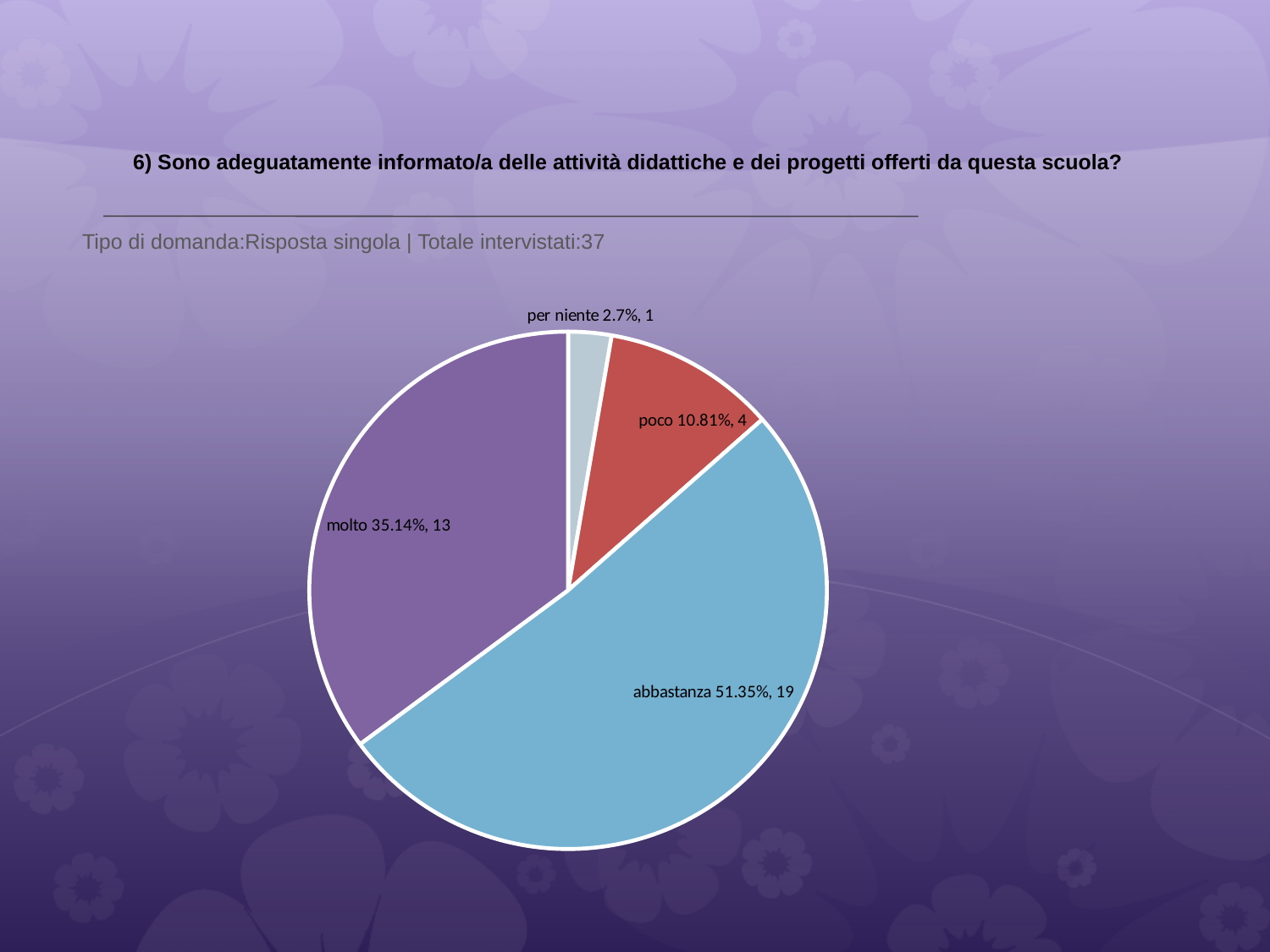
What percentage is shown for the 'abbastanza' slice? 51.35% Which category has the largest slice of the pie? abbastanza What is the difference in respondent count between 'abbastanza' and 'molto'? 6 Which category has the smallest slice of the pie? per niente Which slice is larger, 'poco' or 'molto'? molto How many slices does the pie chart have? 4 What is the total number of respondents across all slices? 37 What percentage is shown for the 'poco' slice? 10.81% How many respondents answered 'molto'? 13 How many respondents answered 'per niente'? 1 What colour is the 'abbastanza' slice? blue What kind of chart is shown on the slide? pie chart